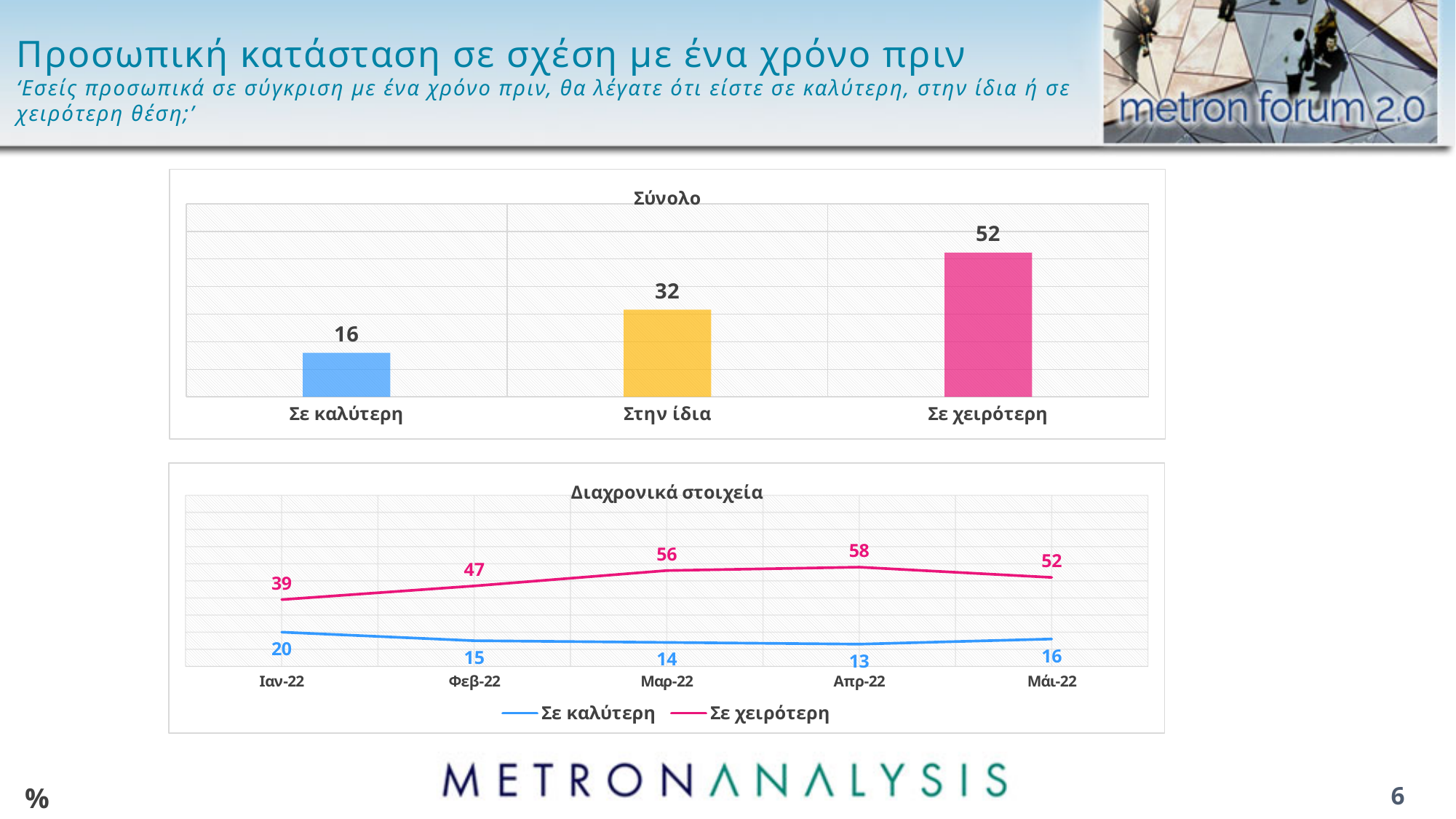
In the 'Διαχρονικά στοιχεία' chart, in which month is 'Σε χειρότερη' highest? Απρ-22 In the 'Σύνολο' chart, what is the difference between 'Σε χειρότερη' and 'Στην ίδια'? 20 In the 'Διαχρονικά στοιχεία' chart, how many series does the legend list? 2 In the 'Διαχρονικά στοιχεία' chart, in which month is 'Σε καλύτερη' lowest? Απρ-22 What kind of chart is the 'Σύνολο' chart? Bar chart In the 'Διαχρονικά στοιχεία' chart, what is the value for 'Σε καλύτερη' in Φεβ-22? 15 In the 'Διαχρονικά στοιχεία' chart, what is the value for 'Σε χειρότερη' in Απρ-22? 58 In the 'Σύνολο' chart, how many categories are shown? 3 In the 'Διαχρονικά στοιχεία' chart, what is the difference between 'Σε χειρότερη' and 'Σε καλύτερη' in Ιαν-22? 19 In the 'Σύνολο' chart, which category has the lowest value? Σε καλύτερη In the 'Σύνολο' chart, what is the value for 'Σε χειρότερη'? 52 In the 'Διαχρονικά στοιχεία' chart, does 'Σε χειρότερη' rise or fall from Ιαν-22 to Απρ-22? Rise